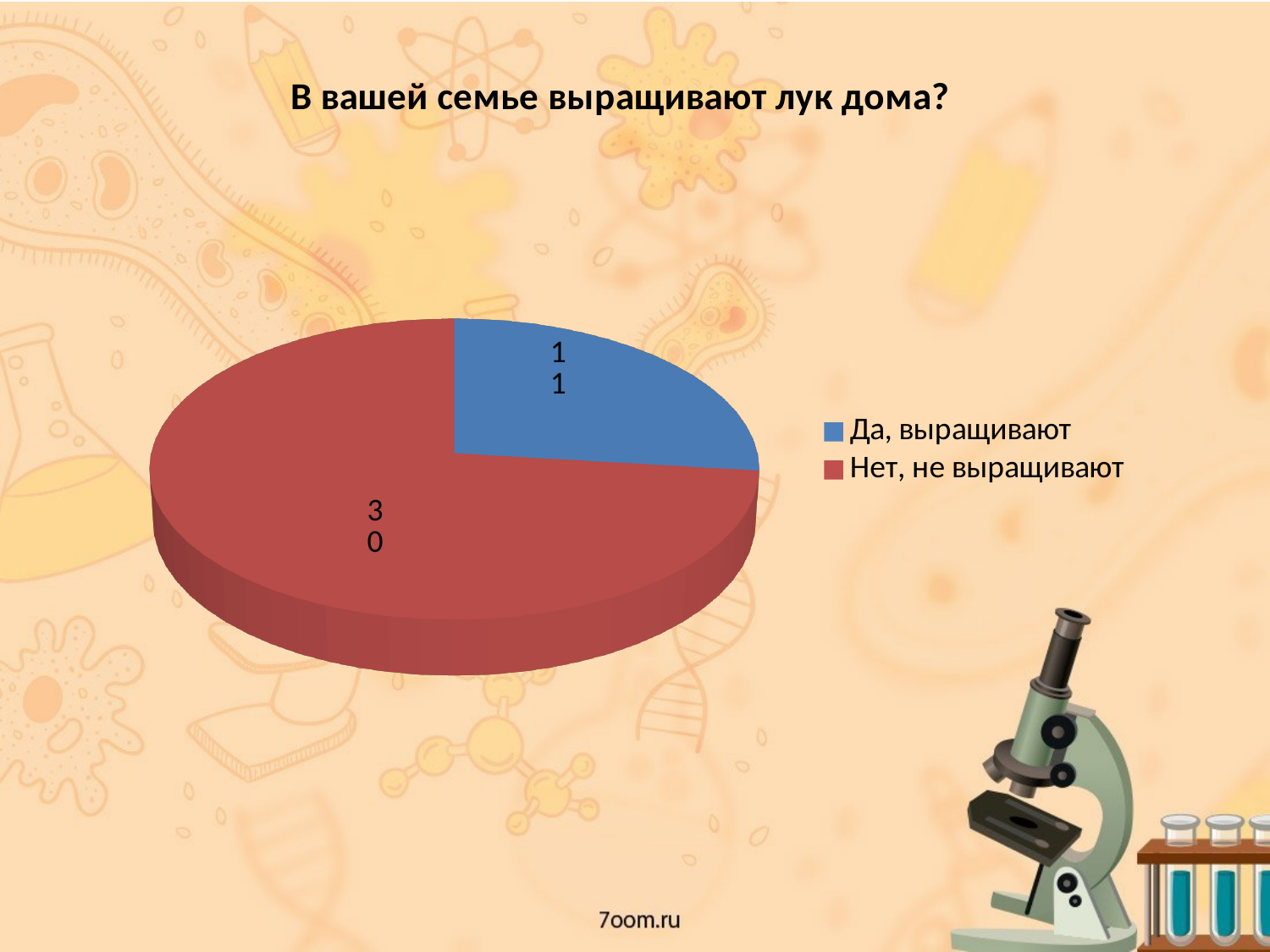
What is the difference between the values for "Нет, не выращивают" and "Да, выращивают"? 19 What is the total of all slices in the pie chart? 41 What kind of chart is shown on the slide? Pie chart How many entries does the legend list? 2 What is the value for "Да, выращивают"? 11 Which category has the largest slice of the pie? Нет, не выращивают How many slices does the pie chart have? 2 What is the title of the chart? В вашей семье выращивают лук дома? Which is larger: the value for "Да, выращивают" or the value for "Нет, не выращивают"? Нет, не выращивают Which category has the smallest slice of the pie? Да, выращивают What colour is the slice for "Да, выращивают"? Blue What is the value for "Нет, не выращивают"? 30